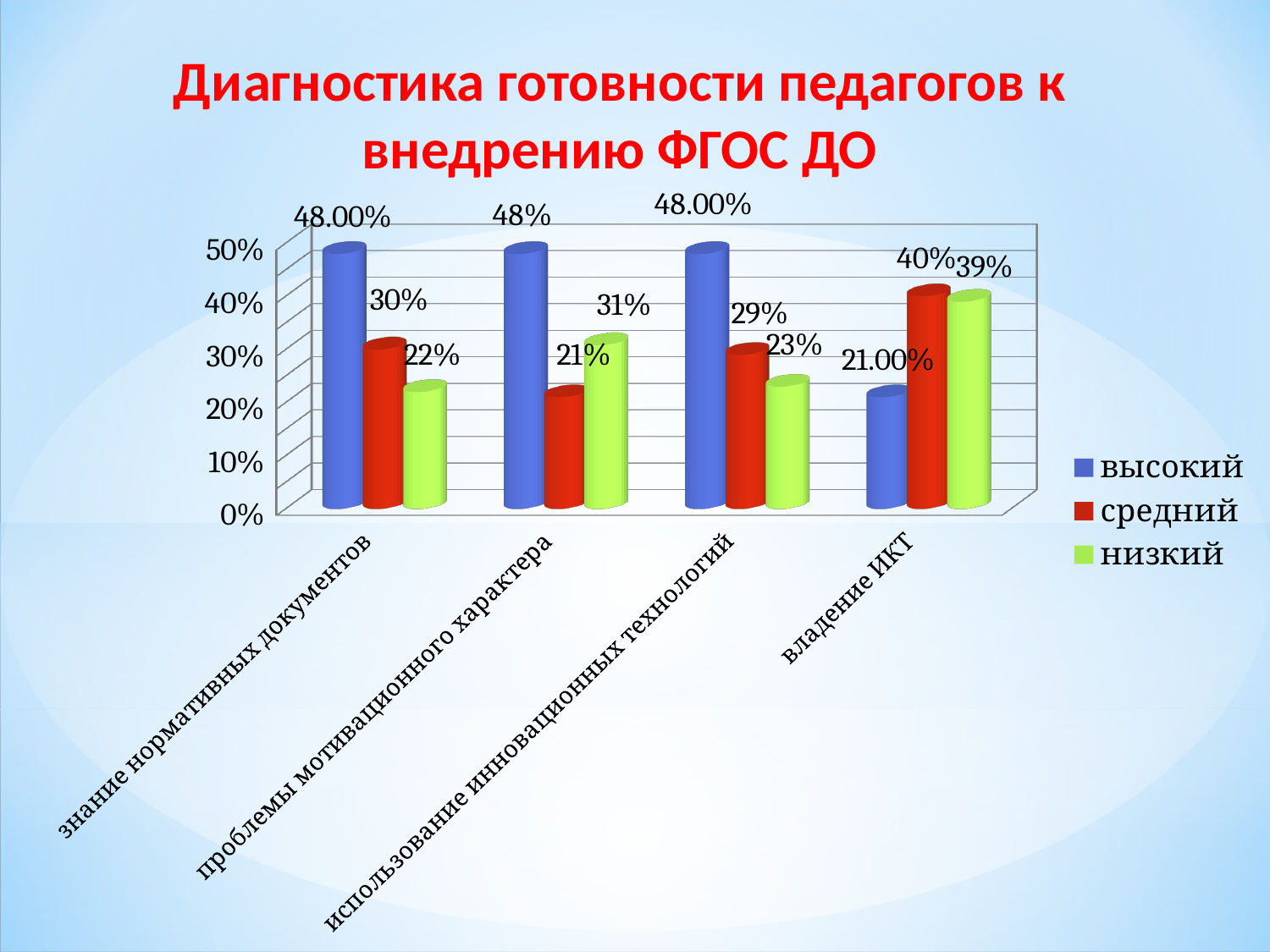
What is the value of the 'низкий' series for 'проблемы мотивационного характера'? 31% For 'проблемы мотивационного характера', which is larger: the 'средний' value or the 'низкий' value? низкий What is the value of the 'высокий' series for 'владение ИКТ'? 21.00% How many categories are shown on the x axis? 4 What is the difference between the 'средний' and 'низкий' values for 'использование инновационных технологий'? 6% How many series does the legend list? 3 What is the value of the 'средний' series for 'владение ИКТ'? 40% Which category has the lowest value in the 'высокий' series? владение ИКТ What kind of chart is shown on the slide? bar chart What is the value of the 'высокий' series for 'знание нормативных документов'? 48.00% Which category has the highest value in the 'средний' series? владение ИКТ What colour represents the 'низкий' series in the legend? green